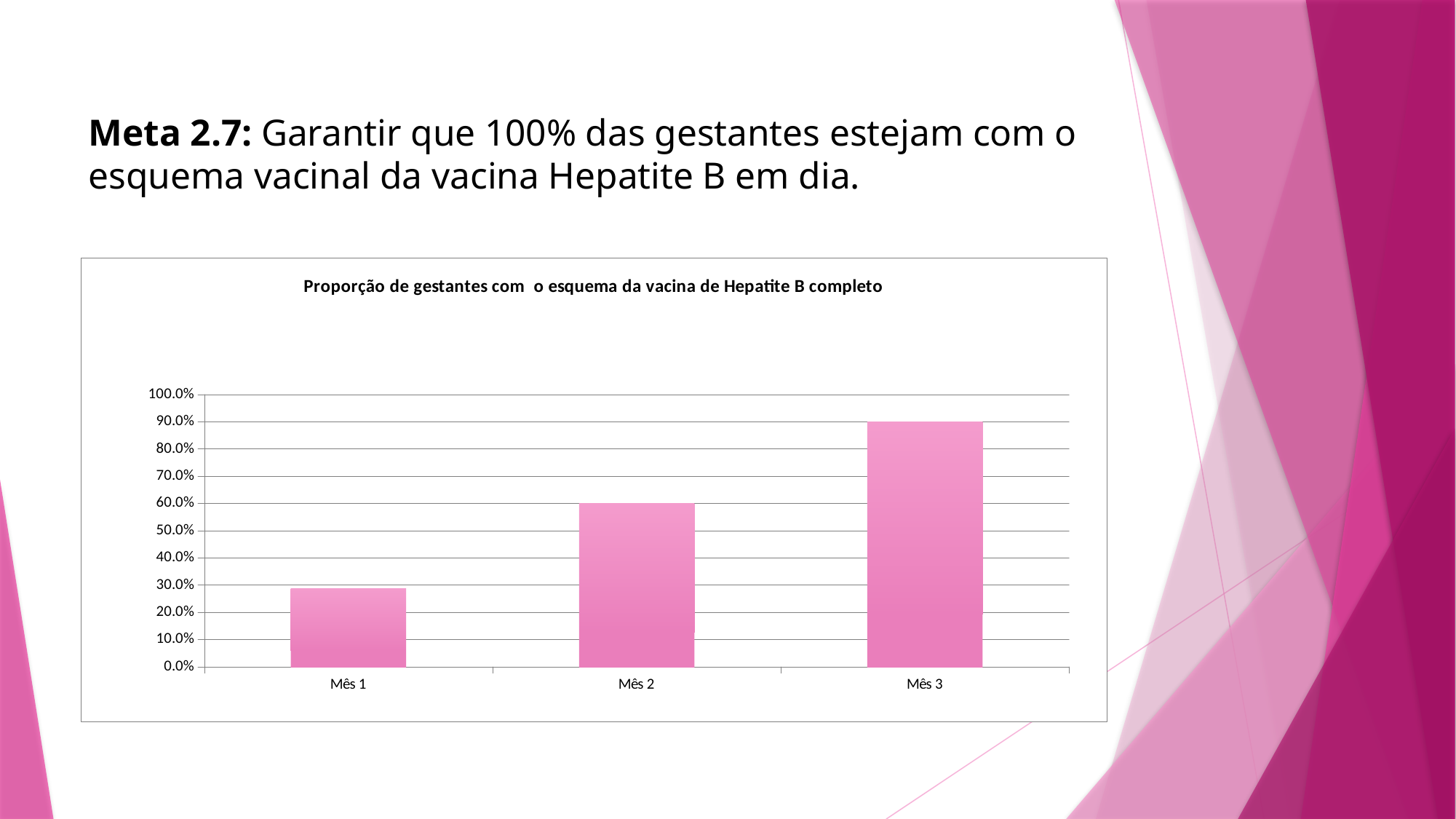
Which month has the lowest value? Mês 1 What is the difference between the values for Mês 3 and Mês 2? 30.0% Is the value for Mês 1 greater or less than 50.0%? less How many categories are shown on the x axis of the chart? 3 What is the value for Mês 2? 60.0% Is the value for Mês 1 greater or less than 20.0%? greater Which month has the highest value? Mês 3 Do the values rise or fall from Mês 1 to Mês 3? rise Which is larger, the value for Mês 2 or the value for Mês 3? Mês 3 What kind of chart is shown on the slide? bar chart What is the title of the chart? Proporção de gestantes com o esquema da vacina de Hepatite B completo What is the value for Mês 3? 90.0%